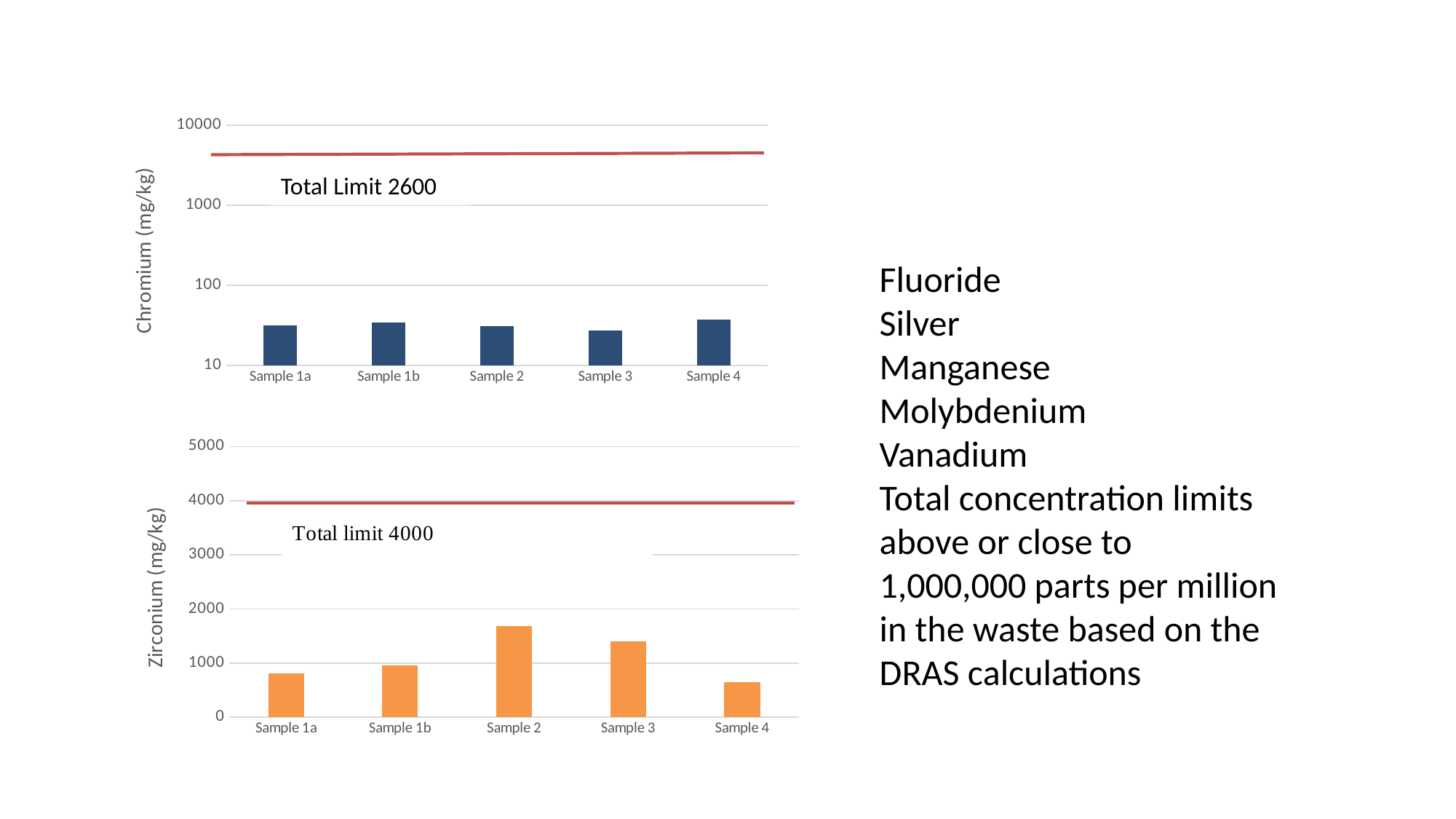
In the bottom chart (Zirconium), which is larger, the value for Sample 2 or the value for Sample 3? Sample 2 In the top chart (Chromium), which sample has the highest value? Sample 4 How many samples are plotted in the bottom chart (Zirconium)? 5 What total limit is labelled on the top chart (Chromium)? Total Limit 2600 In the bottom chart (Zirconium), is the value for Sample 4 greater or less than 1000? less In the top chart (Chromium), is the value for Sample 4 greater or less than 100? less In the bottom chart (Zirconium), which sample has the highest value? Sample 2 In the bottom chart (Zirconium), is the value for Sample 2 greater or less than 2000? less What type of chart is the top chart (Chromium)? bar chart In the bottom chart (Zirconium), which sample has the lowest value? Sample 4 What is the y-axis label of the bottom chart? Zirconium (mg/kg)